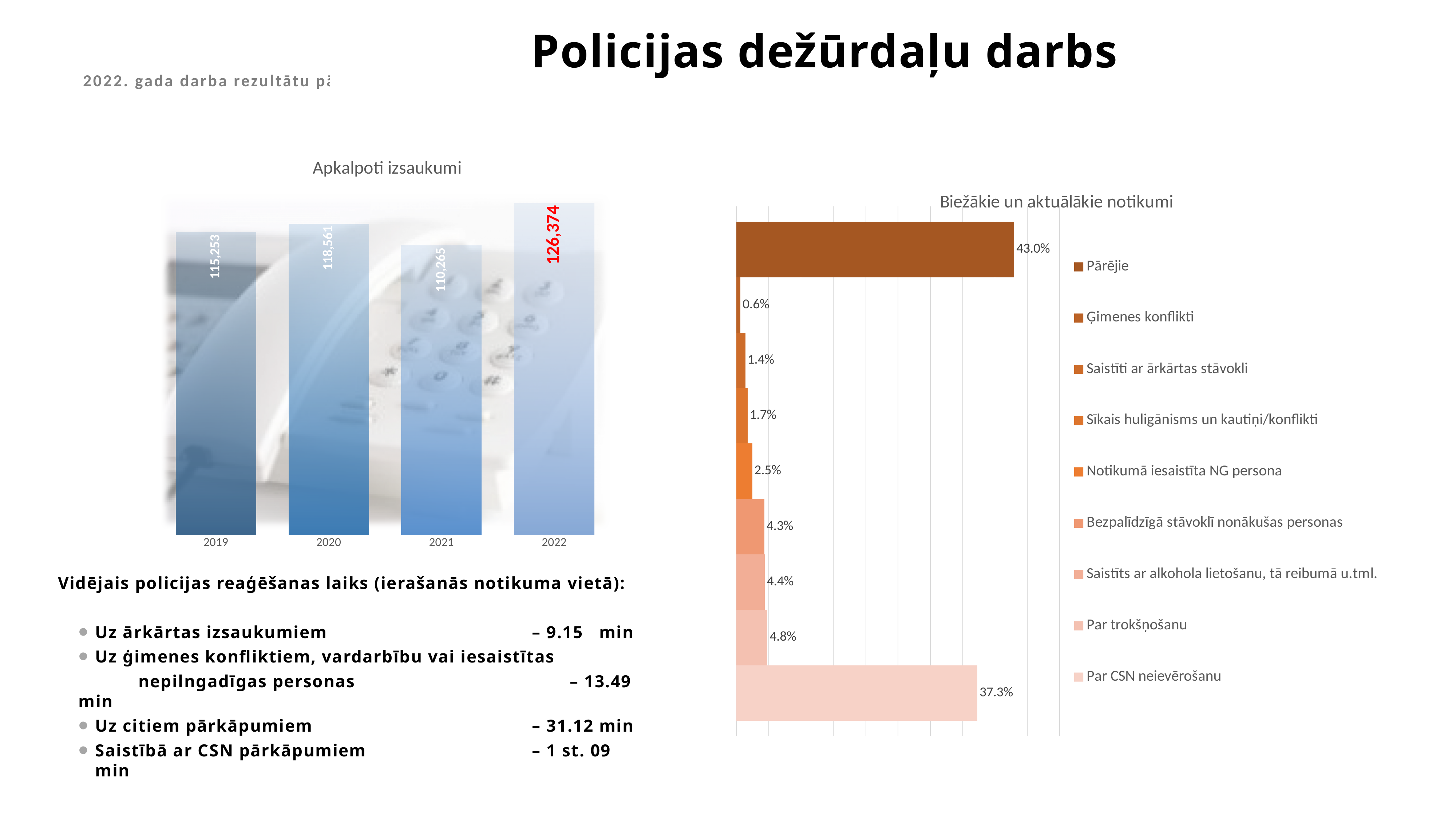
What kind of chart is 'Apkalpoti izsaukumi'? bar chart In the 'Biežākie un aktuālākie notikumi' chart, what is the value for 'Par CSN neievērošanu'? 37.3% In the 'Apkalpoti izsaukumi' chart, what is the value for 2019? 115,253 How many entries does the legend of the 'Biežākie un aktuālākie notikumi' chart list? 9 In the 'Apkalpoti izsaukumi' chart, which year has the highest value? 2022 How many years are shown in the 'Apkalpoti izsaukumi' chart? 4 In the 'Apkalpoti izsaukumi' chart, what is the difference between the 2022 and 2021 values? 16,109 In the 'Apkalpoti izsaukumi' chart, which is larger, the value for 2020 or the value for 2019? 2020 In the 'Biežākie un aktuālākie notikumi' chart, what is the value for 'Pārējie'? 43.0% In the 'Biežākie un aktuālākie notikumi' chart, which category has the lowest value? Ģimenes konflikti In the 'Apkalpoti izsaukumi' chart, which year has the lowest value? 2021 In the 'Apkalpoti izsaukumi' chart, what is the value for 2022? 126,374